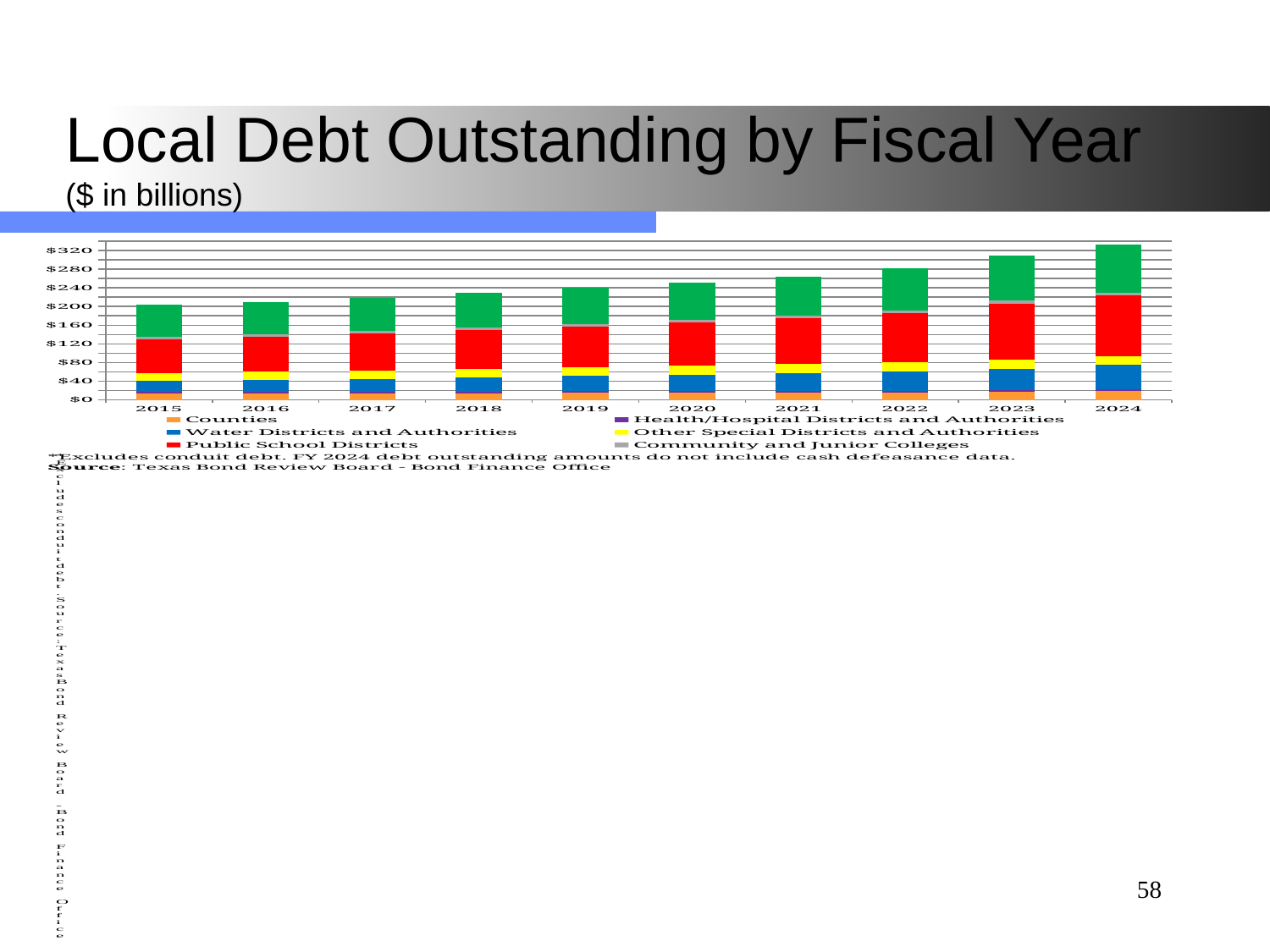
Which fiscal year has the tallest stacked bar (highest total local debt outstanding)? 2024 Do the total stacked bar heights rise or fall from 2015 to 2024? Rise How many fiscal years are shown on the x axis of the chart? 10 Is the total stacked bar for 2021 greater or less than $240? greater What kind of chart is shown on the slide? Stacked bar chart Is the total stacked bar for 2015 greater or less than $240? less Is the total stacked bar for 2023 greater or less than $280? greater How many series does the chart's legend list? 6 Which colour represents Public School Districts in the chart's legend? Red Which fiscal year has the larger total stacked bar, 2016 or 2022? 2022 Which fiscal year has the shortest stacked bar (lowest total local debt outstanding)? 2015